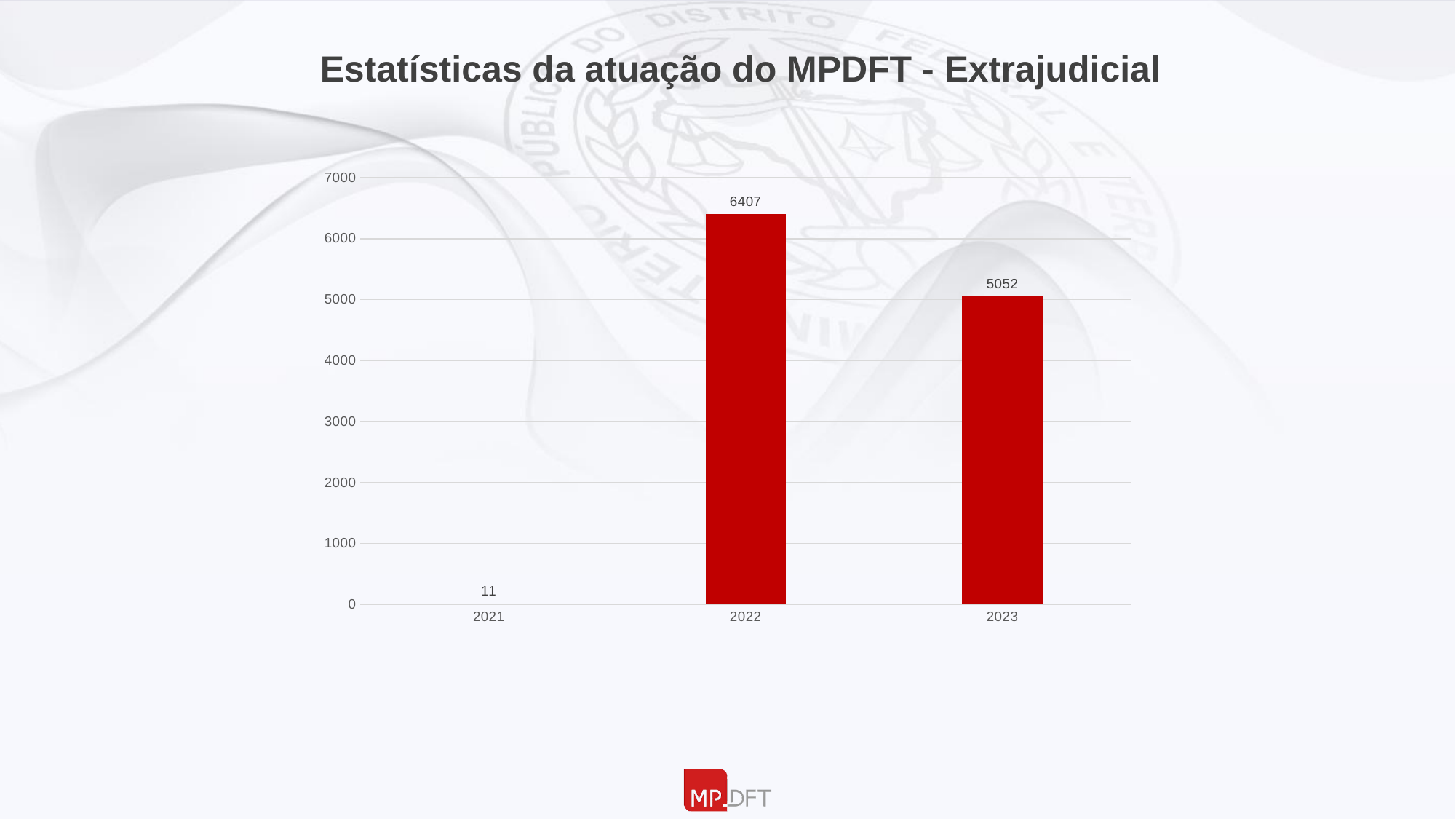
Is the value for 2023 greater or less than 5000? greater Which year has the lowest value? 2021 What is the difference between the values for 2022 and 2023? 1355 What kind of chart is shown on the slide? bar chart What is the value for 2022? 6407 How many years are shown on the x axis? 3 What is the value for 2023? 5052 What is the title of the chart? Estatísticas da atuação do MPDFT - Extrajudicial What colour are the bars in the chart? red Which year has the highest value? 2022 What is the value for 2021? 11 Which is larger, the value for 2022 or the value for 2023? 2022